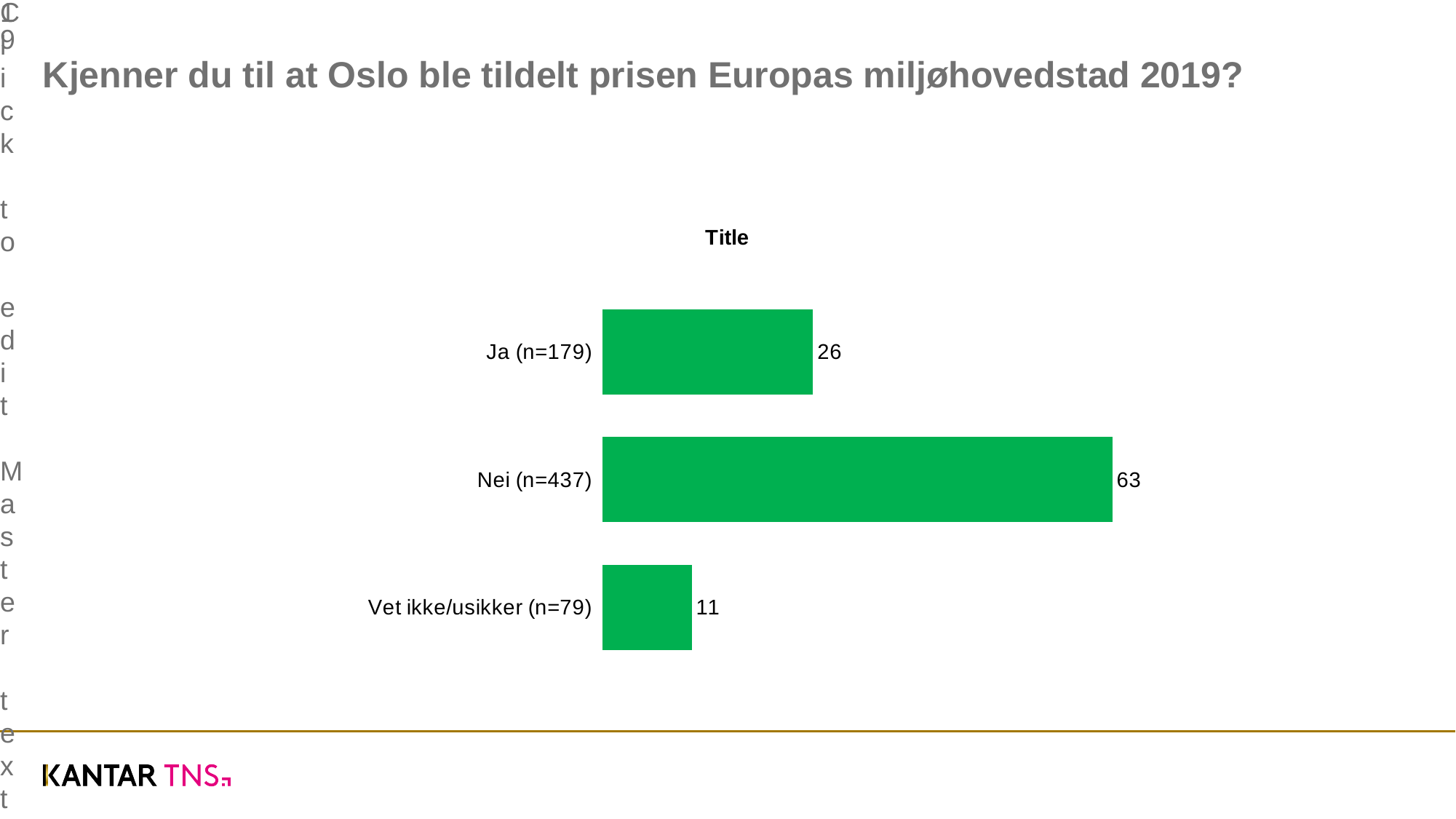
Which category has the highest value? Nei (n=437) What colour are the bars in the chart? Green What is the title printed above the chart? Title What is the difference between the values for Nei (n=437) and Ja (n=179)? 37 What is the value for Ja (n=179)? 26 What kind of chart is shown on the slide? Bar chart What is the value for Nei (n=437)? 63 What is the difference between the values for Ja (n=179) and Vet ikke/usikker (n=79)? 15 What is the value for Vet ikke/usikker (n=79)? 11 Which category has the lowest value? Vet ikke/usikker (n=79) Which is larger, the value for Ja (n=179) or the value for Vet ikke/usikker (n=79)? Ja (n=179) How many categories are shown in the chart? 3